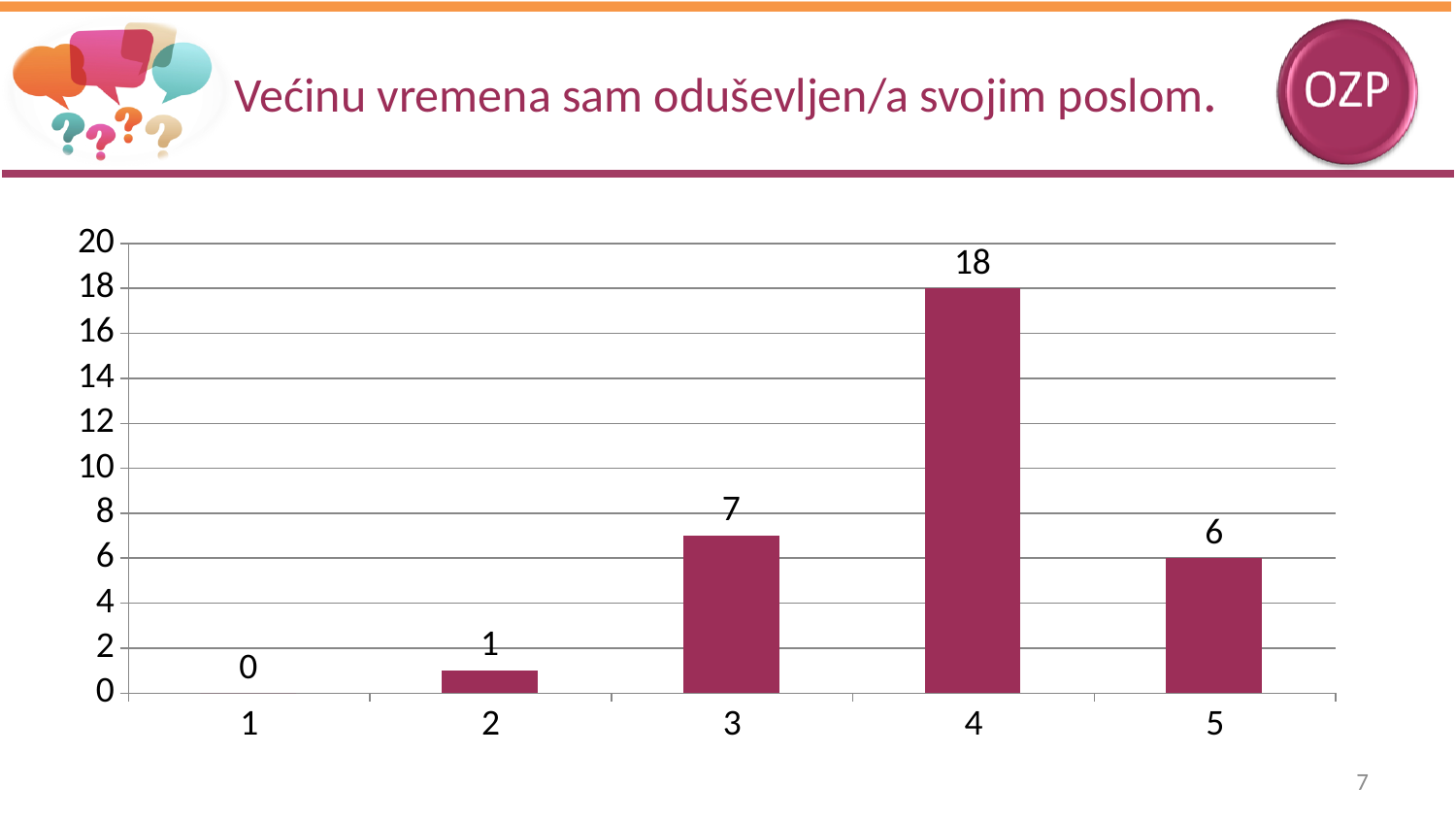
What is the difference between the values for category 4 and category 3? 11 Is the value for category 4 greater or less than 10? greater Which category has the lowest value? 1 Which is larger, the value for category 3 or the value for category 5? 3 What is the value for category 4? 18 Which category has the highest value? 4 What is the value for category 3? 7 What kind of chart is shown on the slide? bar chart How many categories are shown on the x axis? 5 What is the title of the slide above the chart? Većinu vremena sam oduševljen/a svojim poslom. What is the value for category 1? 0 What is the value for category 5? 6